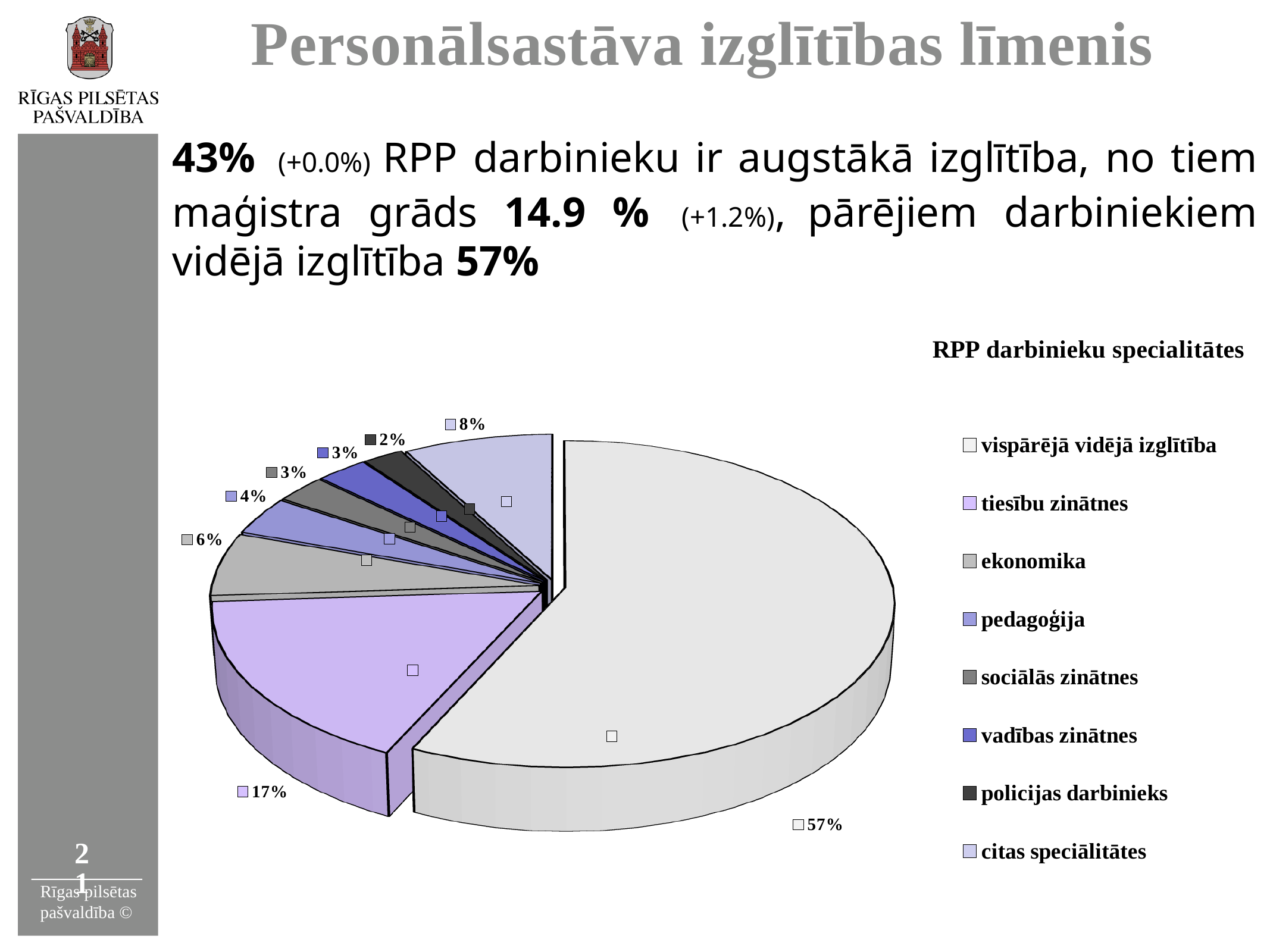
What share of the pie does tiesību zinātnes have? 17% What is the title of the chart? RPP darbinieku specialitātes What share of the pie does ekonomika have? 6% What share of the pie does vispārējā vidējā izglītība have? 57% Which category has the smallest share of the pie? policijas darbinieks How many categories does the pie chart have? 8 What share of the pie does pedagoģija have? 4% Which category has the largest share of the pie? vispārējā vidējā izglītība What is the difference between the shares of vispārējā vidējā izglītība and tiesību zinātnes? 40% What kind of chart is shown on the slide? pie chart What share of the pie does citas speciālitātes have? 8% Which has a larger share, citas speciālitātes or ekonomika? citas speciālitātes